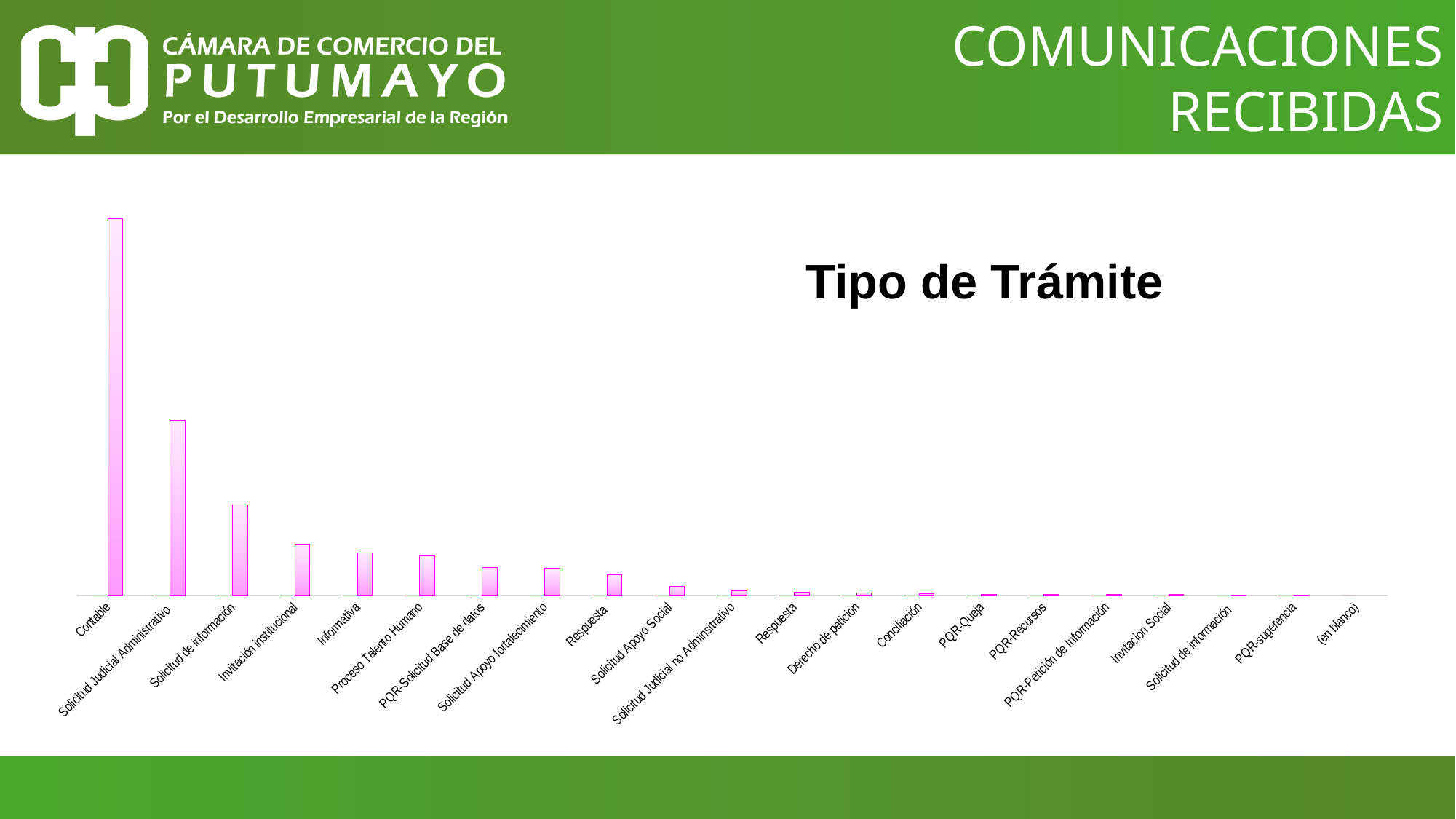
Which category is the first (leftmost) on the x axis? Contable Which is larger, the value for Solicitud de información (third bar) or the value for Invitación institucional? Solicitud de información What kind of chart is shown on the slide? Bar chart Which category has the highest value in the chart? Contable Which is larger, the value for Contable or the value for Solicitud Judicial Administrativo? Contable Which is larger, the value for Solicitud Judicial Administrativo or the value for Solicitud de información (third bar)? Solicitud Judicial Administrativo How many categories are shown on the x axis of the chart? 21 Do the values rise or fall from left to right along the x axis? Fall What colour are the bars in the chart? Pink What is the title of the chart? Tipo de Trámite